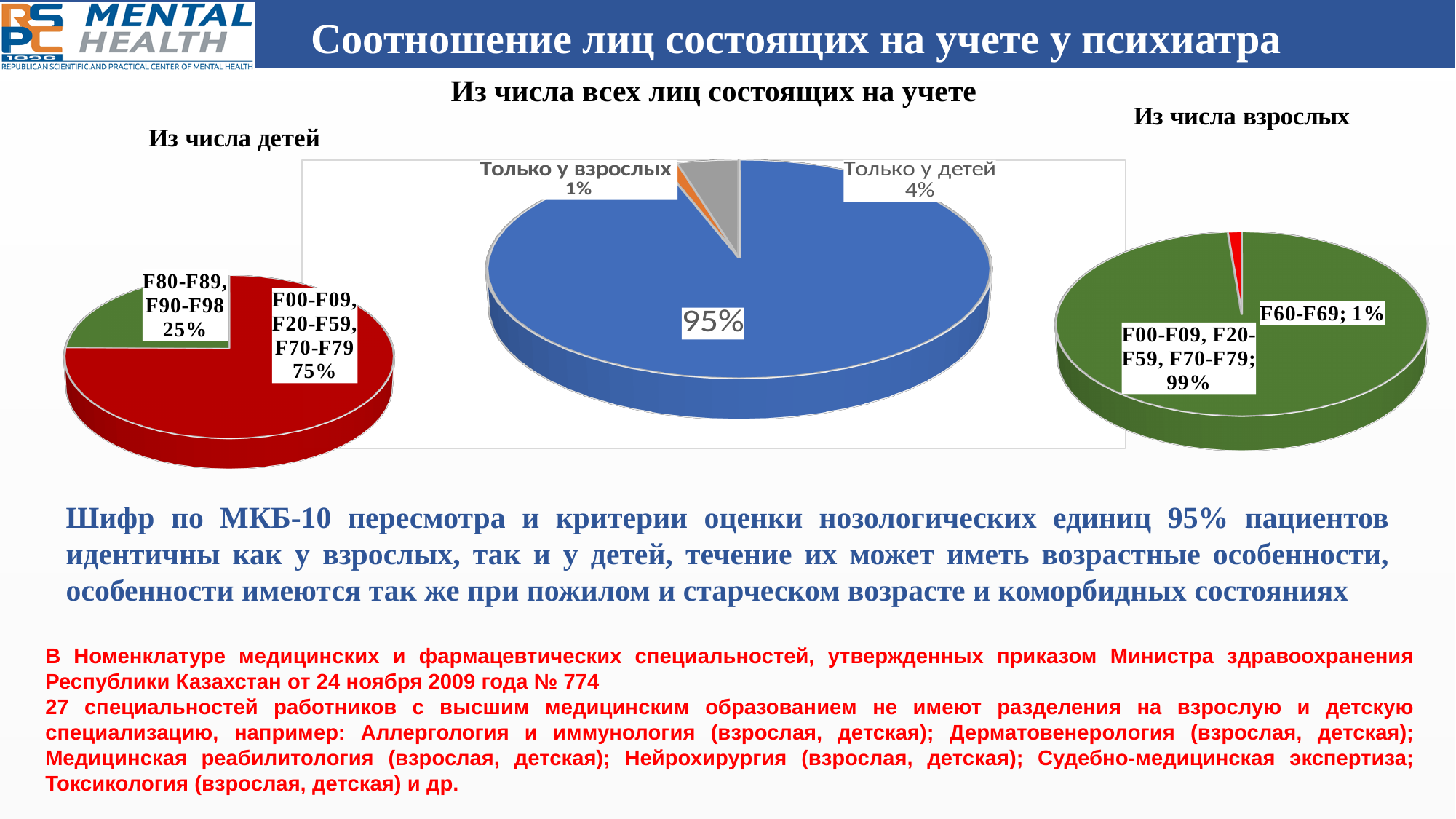
How many slices does the 'Из числа детей' pie chart have? 2 In the 'Из числа взрослых' chart, what share is shown for F60-F69? 1% In the middle chart, which is larger: 'Только у детей' or 'Только у взрослых'? Только у детей In the 'Из числа детей' chart, what share is shown for F00-F09, F20-F59, F70-F79? 75% In the 'Из числа взрослых' chart, what share is shown for F00-F09, F20-F59, F70-F79? 99% In the 'Из числа детей' chart, what is the difference between the two slices' percentages? 50% In the 'Из числа детей' chart, which slice is the largest? F00-F09, F20-F59, F70-F79 What kind of chart is used for 'Из числа детей'? pie chart In the middle chart 'Из числа всех лиц состоящих на учете', what percentage is shown on the large blue slice? 95%